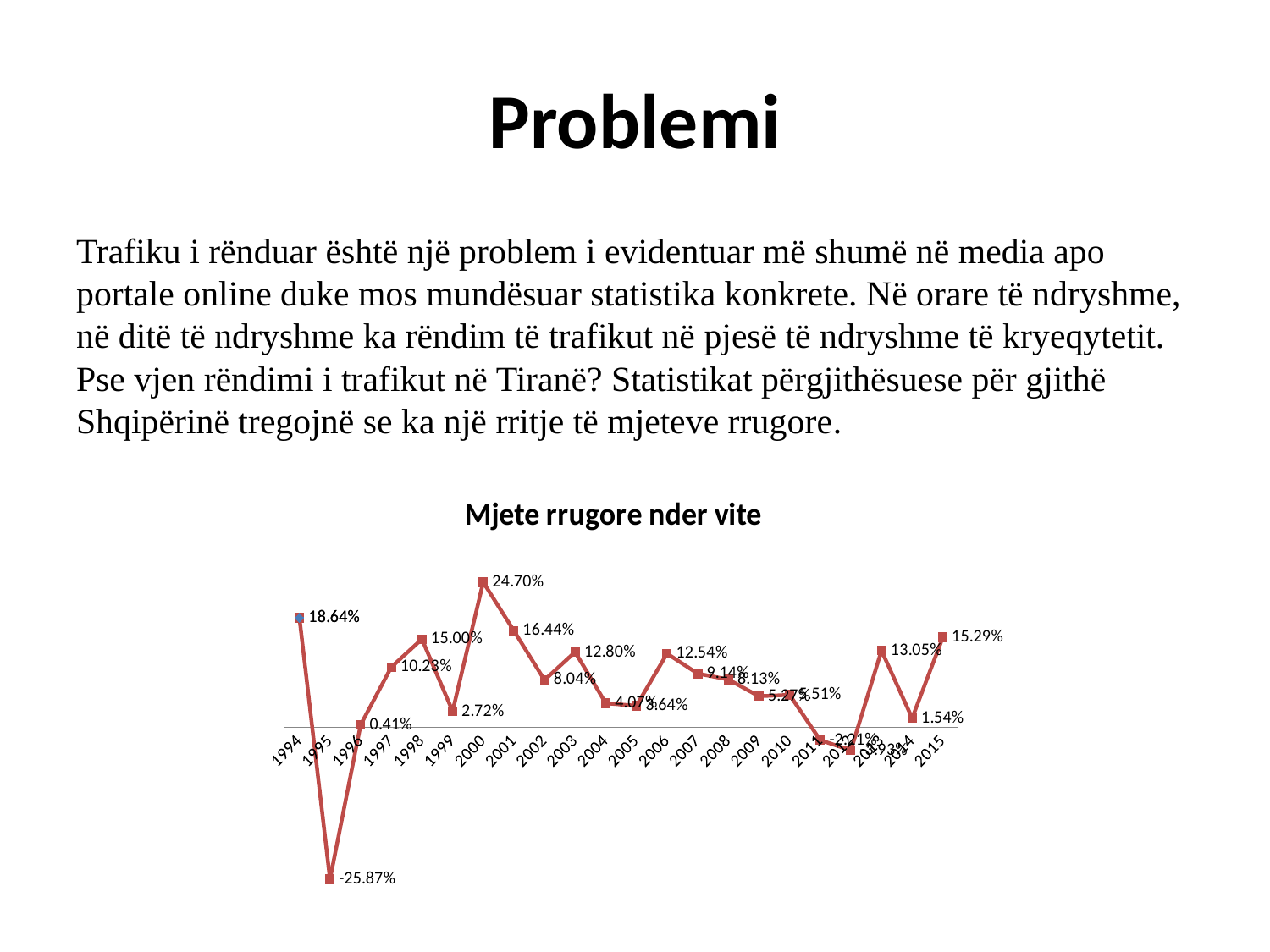
What is the title of the chart? Mjete rrugore nder vite What is the value for 2015? 15.29% How many years are plotted on the x axis? 22 Which year has the lowest value? 1995 What is the difference between the values for 2000 and 1994? 6.06 percentage points What is the value for 1999? 2.72% What kind of chart is shown on the slide? line chart Which year has the highest value? 2000 What is the value for 1995? -25.87% What is the value for 2000? 24.70% What is the difference between the values for 2015 and 2014? 13.75 percentage points Which is larger, the value for 2013 or the value for 2015? 2015